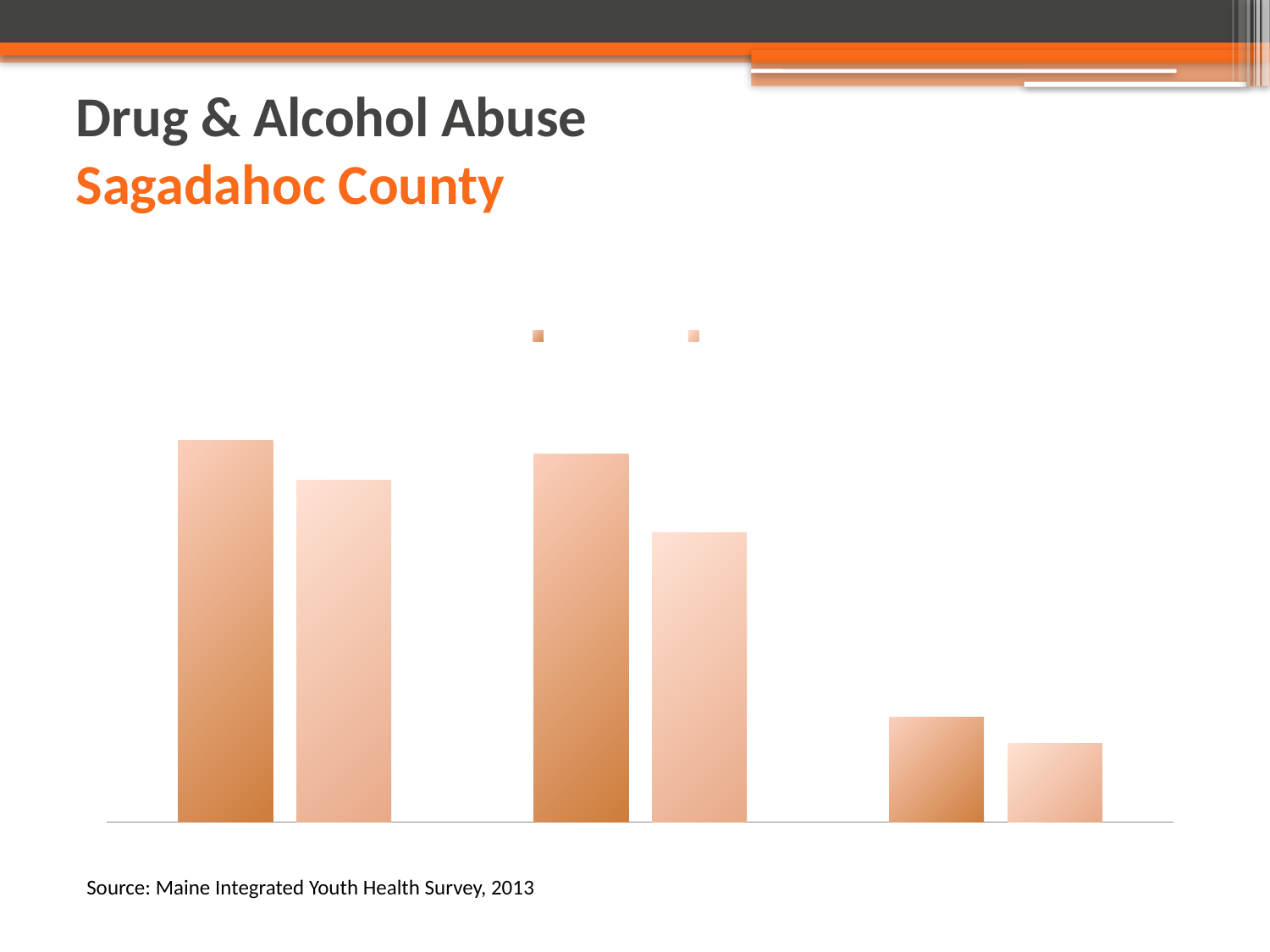
What source is cited below the chart? Maine Integrated Youth Health Survey, 2013 What kind of chart is shown on the slide? bar chart Which group of bars is the tallest: the left, middle, or right group? left Which county is named in the slide title? Sagadahoc County Do the bar heights rise or fall moving from left to right across the groups? fall Which group of bars is the shortest: the left, middle, or right group? right How many series does the legend list? 2 How many bars are plotted in total on the chart? 6 Within each group of bars, is the darker orange bar taller or shorter than the lighter bar? taller How many groups of bars does the chart show? 3